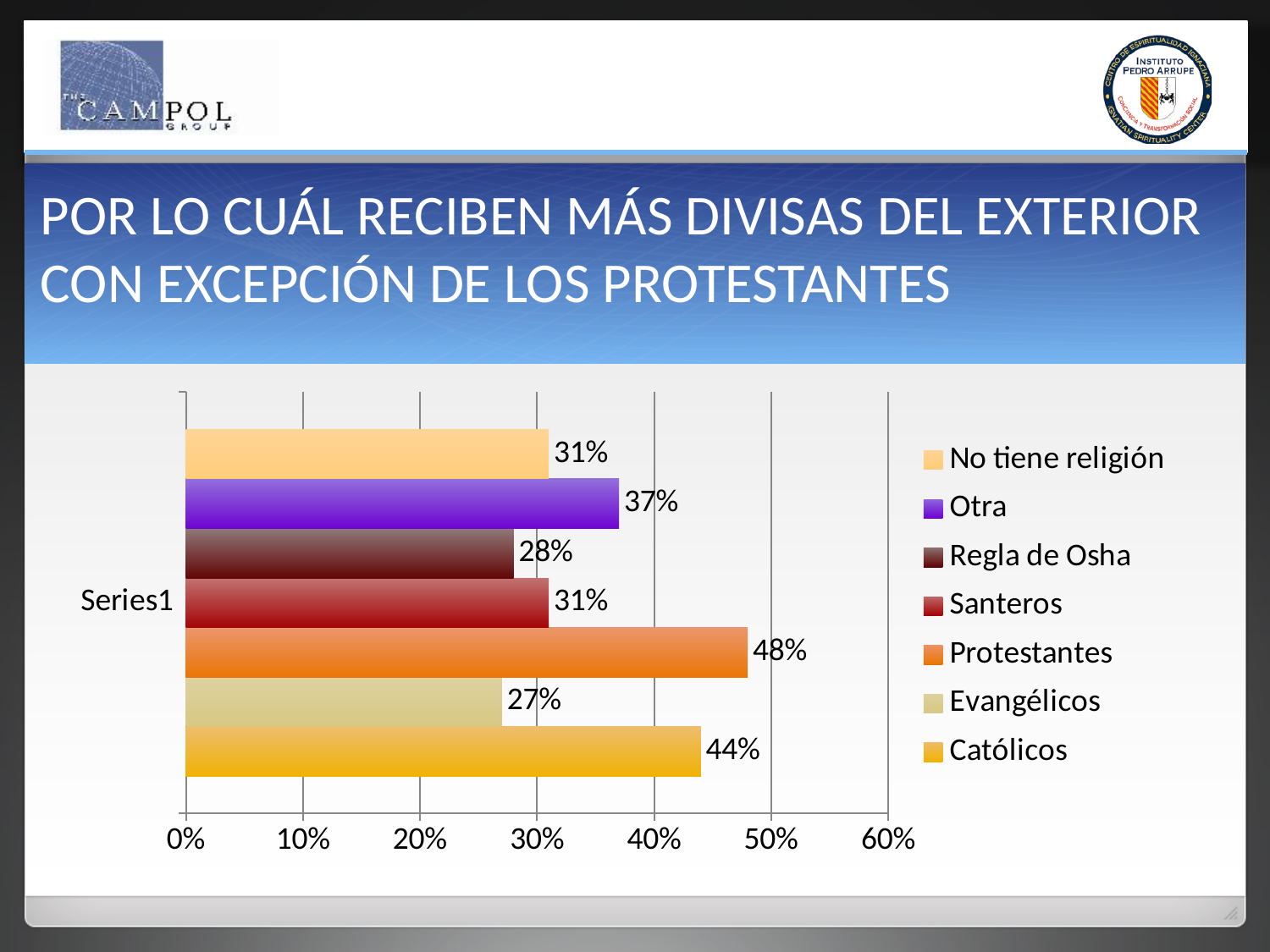
How many bars are plotted in the chart? 7 What is the value for Regla de Osha? 28% How many entries does the legend list? 7 Which group has the highest value? Protestantes What is the difference between the values for Protestantes and Católicos? 4% What is the value for Otra? 37% Is the value for Evangélicos greater or less than 30%? less What is the value for Católicos? 44% Which is larger, the value for Otra or the value for Santeros? Otra Which group has the lowest value? Evangélicos What kind of chart is shown on the slide? bar chart What is the value for Protestantes? 48%